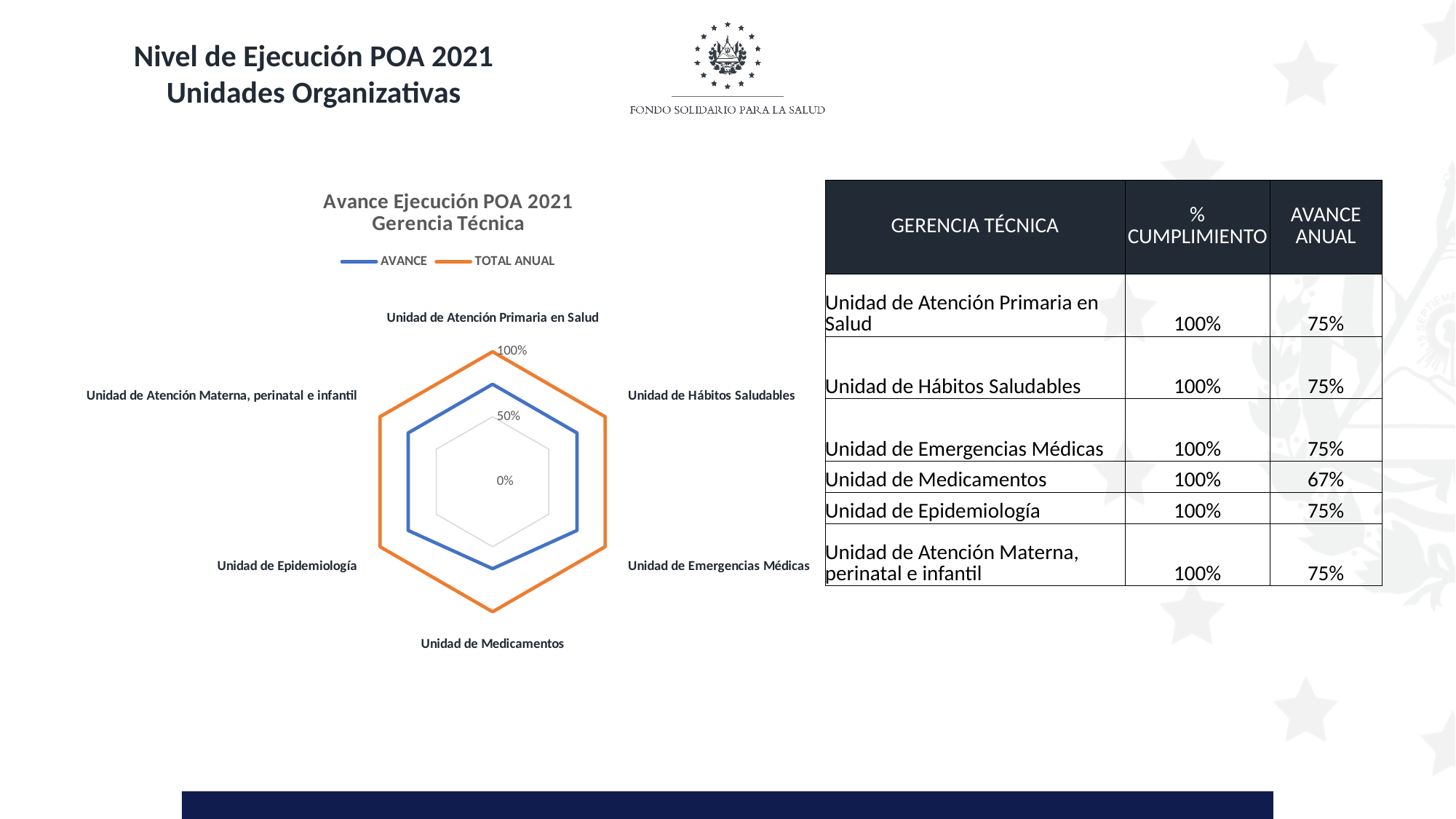
Which colour represents the TOTAL ANUAL series in the chart? Orange How many categories (axes) does the radar chart have? 6 Is the AVANCE value for Unidad de Atención Primaria en Salud greater or less than 100%? less What is the highest value shown on the chart's axis scale? 100% Is the AVANCE value for Unidad de Epidemiología greater or less than 50%? greater What is the title of the chart? Avance Ejecución POA 2021 Gerencia Técnica Which category has the lowest AVANCE value in the chart? Unidad de Medicamentos What is the TOTAL ANUAL value for Unidad de Medicamentos? 100% How many series does the chart legend list? 2 What is the TOTAL ANUAL value for Unidad de Hábitos Saludables? 100% For Unidad de Emergencias Médicas, which series has the larger value, AVANCE or TOTAL ANUAL? TOTAL ANUAL What kind of chart is shown on the slide? Radar chart